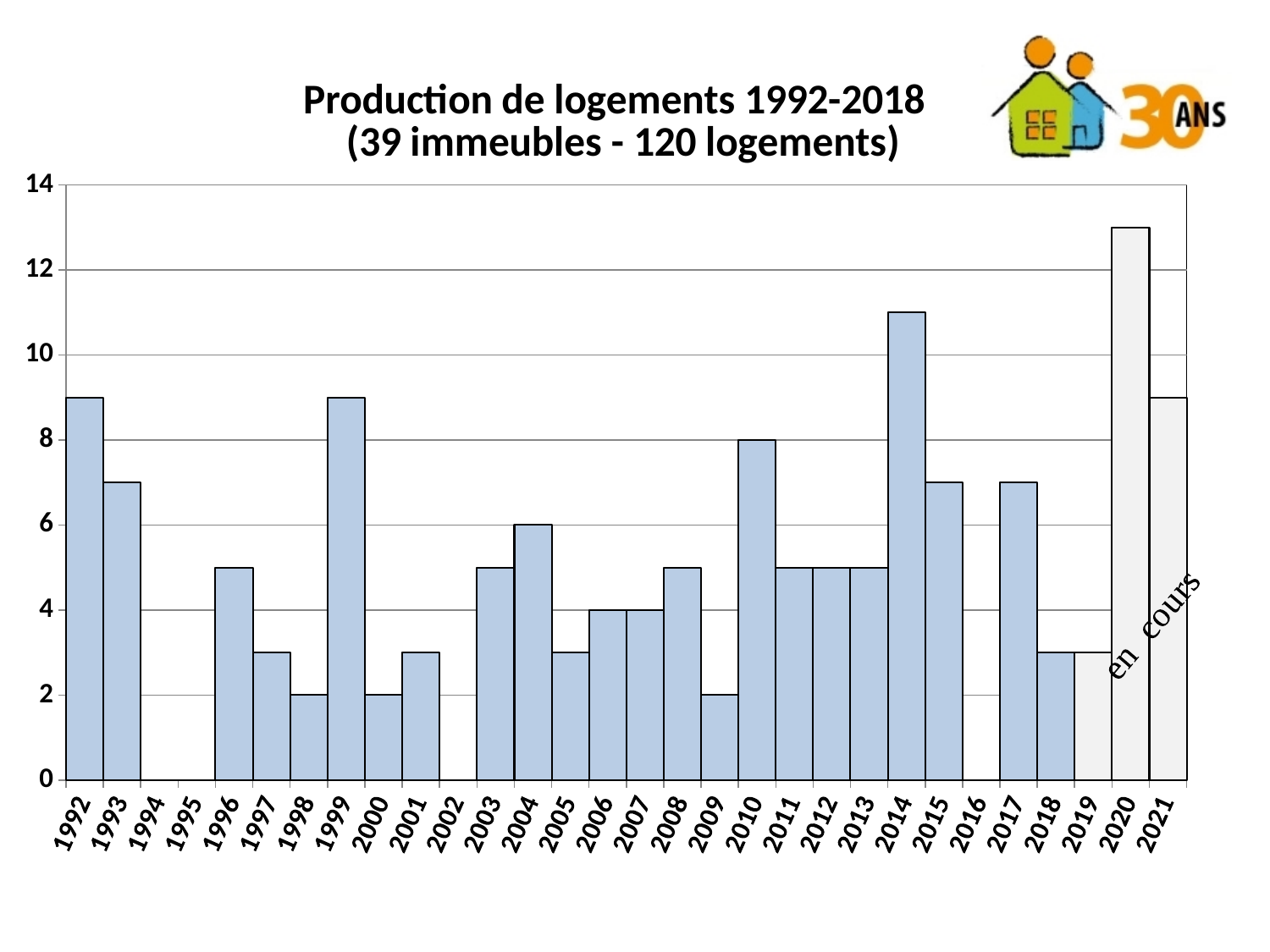
What kind of chart is shown on the slide? bar chart What is the difference between the values for 2010 and 2009? 6 What is the value for 2004? 6 How many years are shown on the x axis? 30 Is the value for 2014 greater or less than 10? greater Which year has the highest bar? 2020 What is the value for 2010? 8 What is the value for 2006? 4 What is the value for 2009? 2 What is the title of the chart? Production de logements 1992-2018 (39 immeubles - 120 logements) Is the value for 2019 greater or less than 4? less Which is larger, the value for 2014 or the value for 2015? 2014